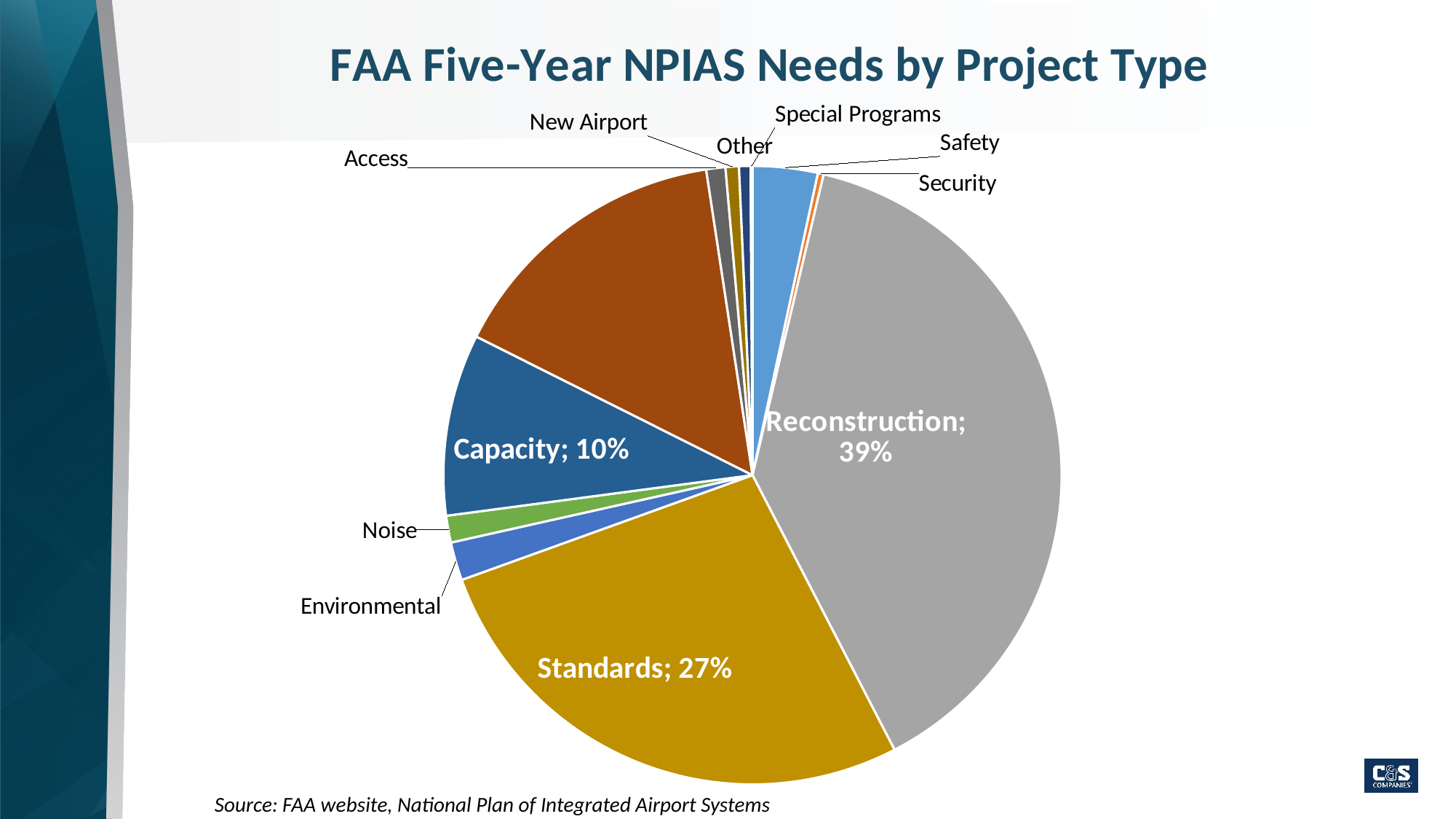
What is the difference between the Standards share and the Capacity share? 17 percentage points How many slices in the pie have a percentage value printed on them? 3 Which project type has the largest slice of the pie? Reconstruction What type of chart is shown on the slide? pie chart What share does the Capacity slice show? 10% What is the title of the chart? FAA Five-Year NPIAS Needs by Project Type What percentage of the pie is labelled for Standards? 27% How many percentage points larger is Reconstruction than Standards? 12 percentage points What share of FAA Five-Year NPIAS needs is for Reconstruction? 39% Which slice is larger, Standards or Capacity? Standards Which slice is larger, Safety or Security? Safety Which slice is larger, Noise or Capacity? Capacity